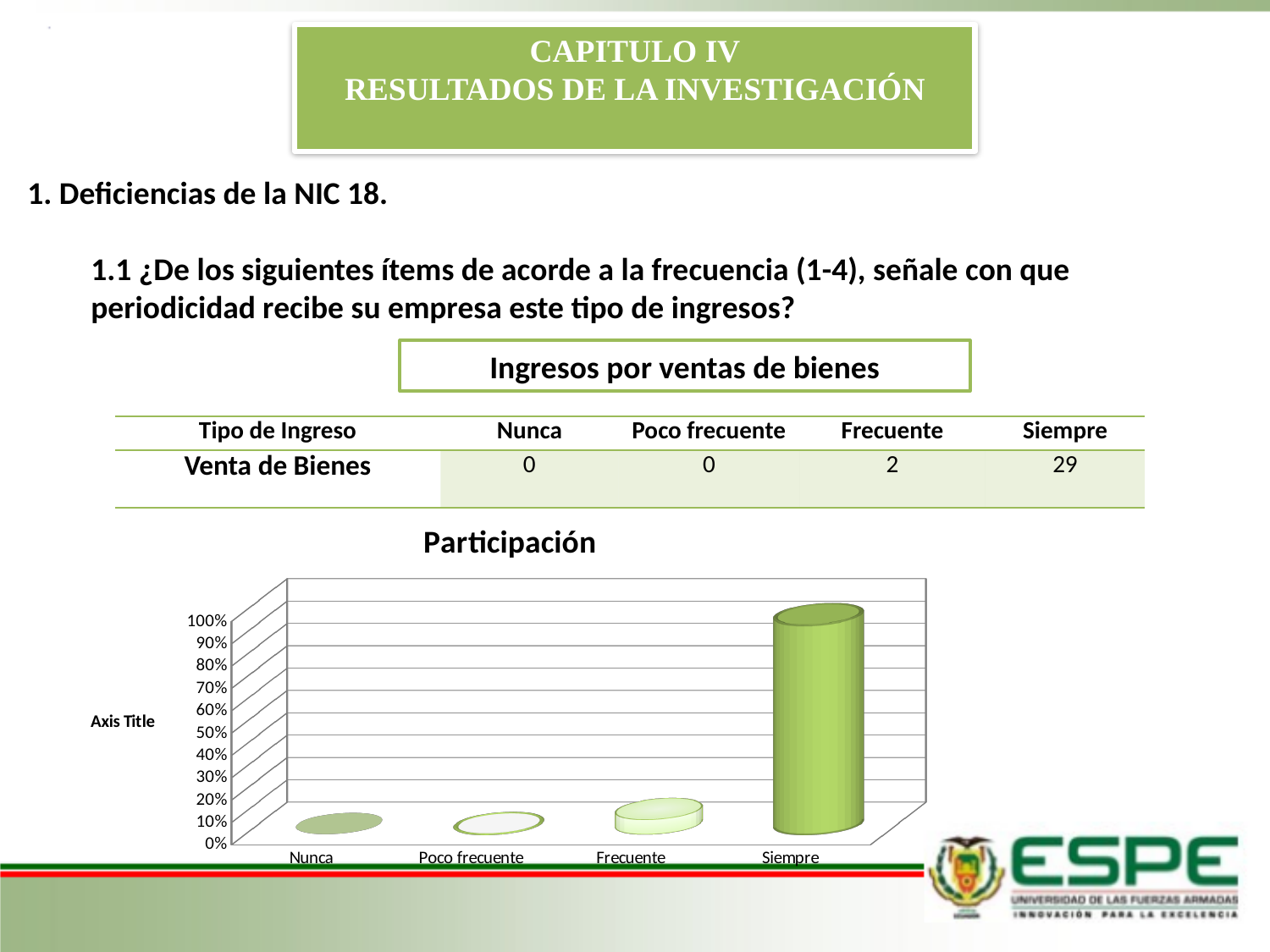
Which category has the highest bar in the "Participación" chart? Siempre In the "Participación" chart, is the value for Siempre greater or less than 80%? greater What is the highest tick value shown on the vertical axis of the "Participación" chart? 100% In the "Participación" chart, is the value for Nunca greater or less than 10%? less What kind of chart is shown under the title "Participación"? bar chart In the "Participación" chart, which is larger, the bar for Siempre or the bar for Frecuente? Siempre What label is shown on the vertical axis of the "Participación" chart? Axis Title How many categories are shown on the x axis of the "Participación" chart? 4 In the "Participación" chart, is the value for Frecuente greater or less than 20%? less What is the title of the chart on the slide? Participación Do the bars in the "Participación" chart generally rise or fall from left to right along the x axis? rise